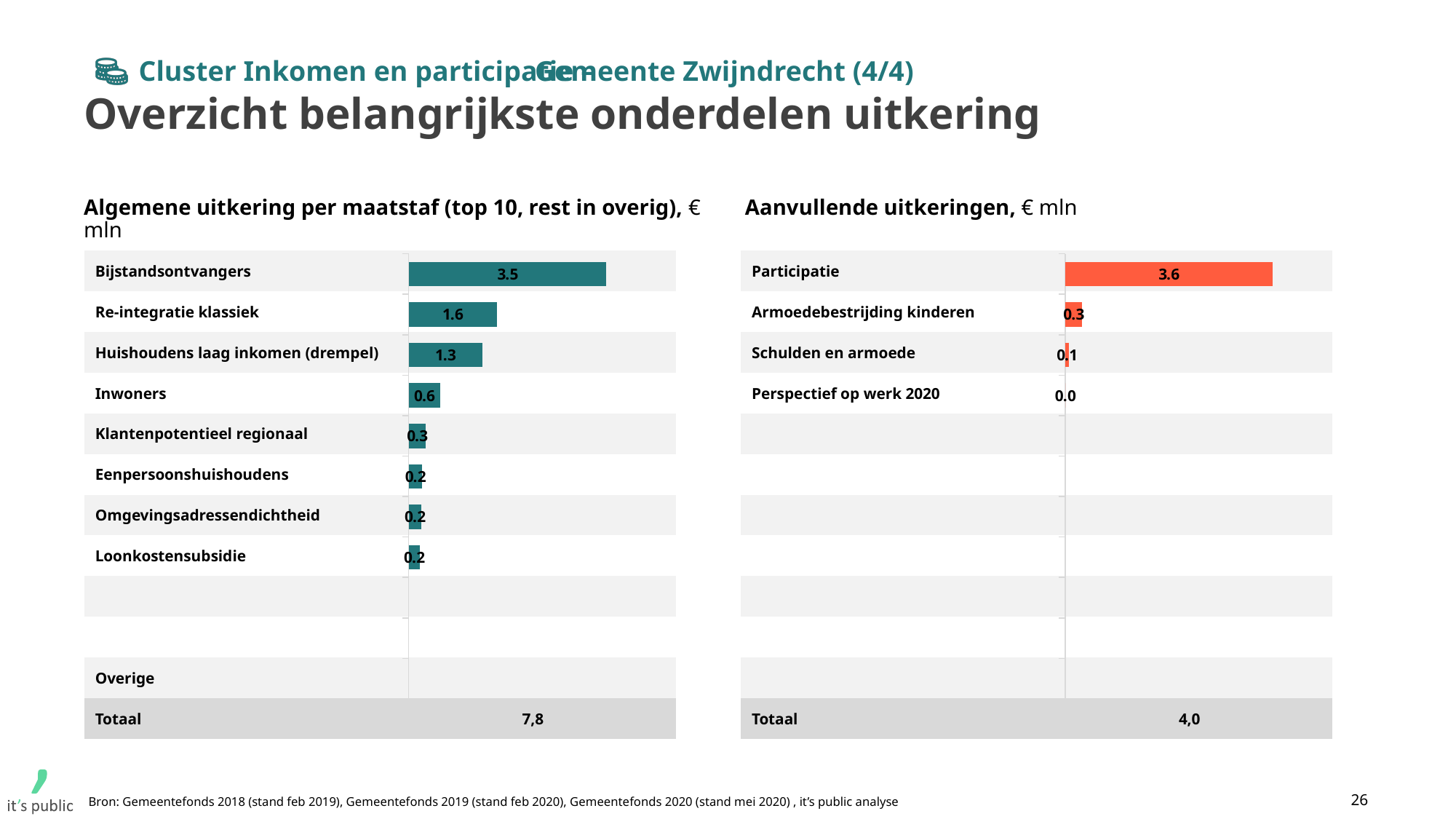
In the right chart (Aanvullende uitkeringen), how many categories have a bar with a value label? 4 In the right chart (Aanvullende uitkeringen), what is the value for Participatie? 3.6 In the left chart (Algemene uitkering per maatstaf), what is the value for Bijstandsontvangers? 3.5 In the left chart (Algemene uitkering per maatstaf), which category has the highest value? Bijstandsontvangers In the left chart (Algemene uitkering per maatstaf), what is the value for Huishoudens laag inkomen (drempel)? 1.3 In the left chart (Algemene uitkering per maatstaf), what is the Totaal shown at the bottom? 7,8 In the right chart (Aanvullende uitkeringen), what is the difference between Participatie and Armoedebestrijding kinderen? 3.3 In the right chart (Aanvullende uitkeringen), which category has the lowest value? Perspectief op werk 2020 In the right chart (Aanvullende uitkeringen), what is the value for Perspectief op werk 2020? 0.0 In the left chart (Algemene uitkering per maatstaf), which is larger: Inwoners or Klantenpotentieel regionaal? Inwoners What type of chart is used on the right side of the slide (Aanvullende uitkeringen)? Bar chart In the left chart (Algemene uitkering per maatstaf), what is the difference between Bijstandsontvangers and Re-integratie klassiek? 1.9